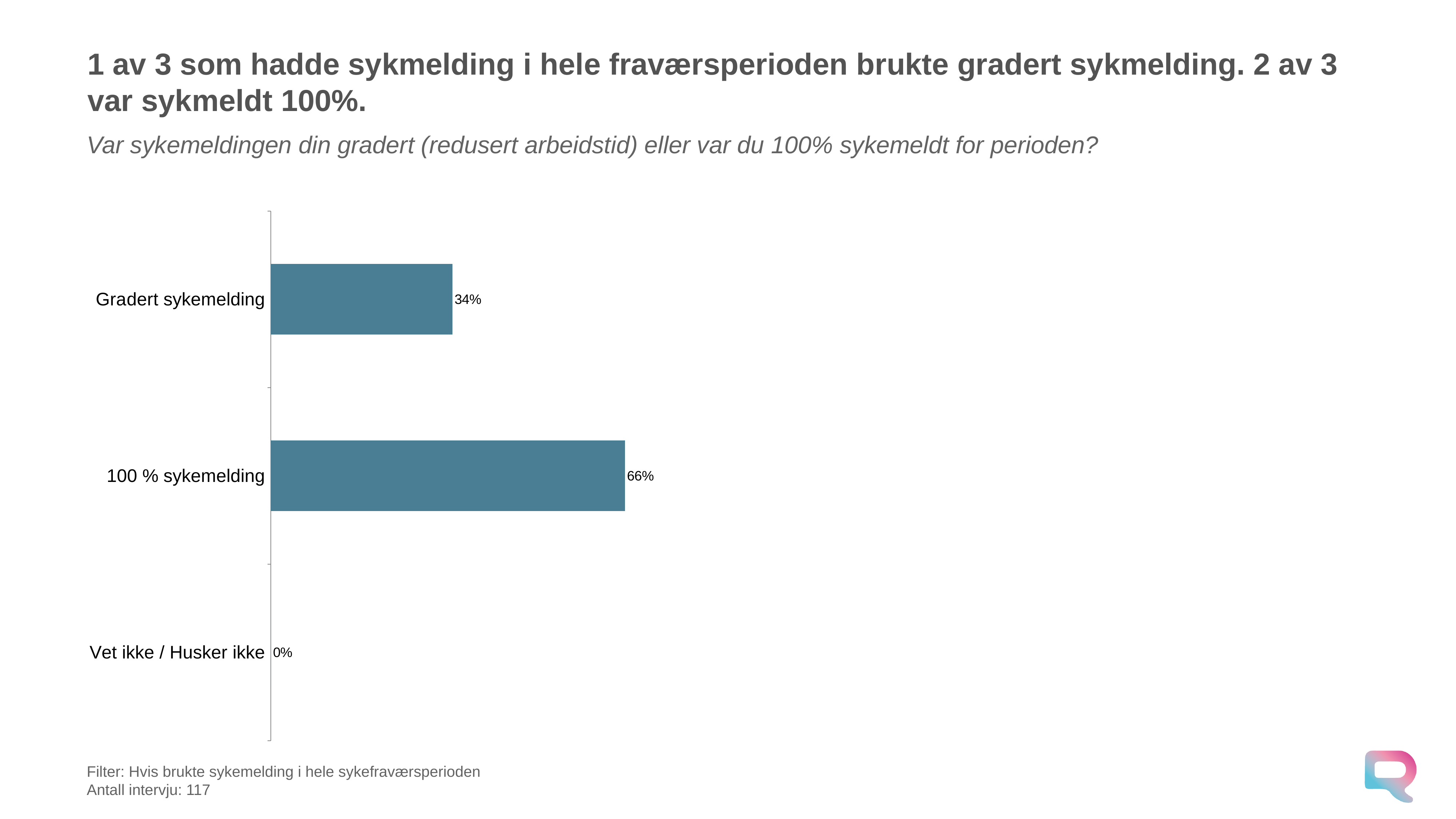
Which category has the lowest value? Vet ikke / Husker ikke Which is larger, the value for Gradert sykemelding or the value for 100 % sykemelding? 100 % sykemelding What is the total of the values for Gradert sykemelding and 100 % sykemelding? 100% What is the number of interviews (Antall intervju) stated below the chart? 117 What is the value for Vet ikke / Husker ikke? 0% What is the value for Gradert sykemelding? 34% What question is the chart based on, as shown in the subtitle? Var sykemeldingen din gradert (redusert arbeidstid) eller var du 100% sykemeldt for perioden? What is the value for 100 % sykemelding? 66% Which category has the highest value? 100 % sykemelding What is the difference between the values for 100 % sykemelding and Gradert sykemelding? 32% What kind of chart is shown on the slide? Bar chart How many categories are shown in the chart? 3